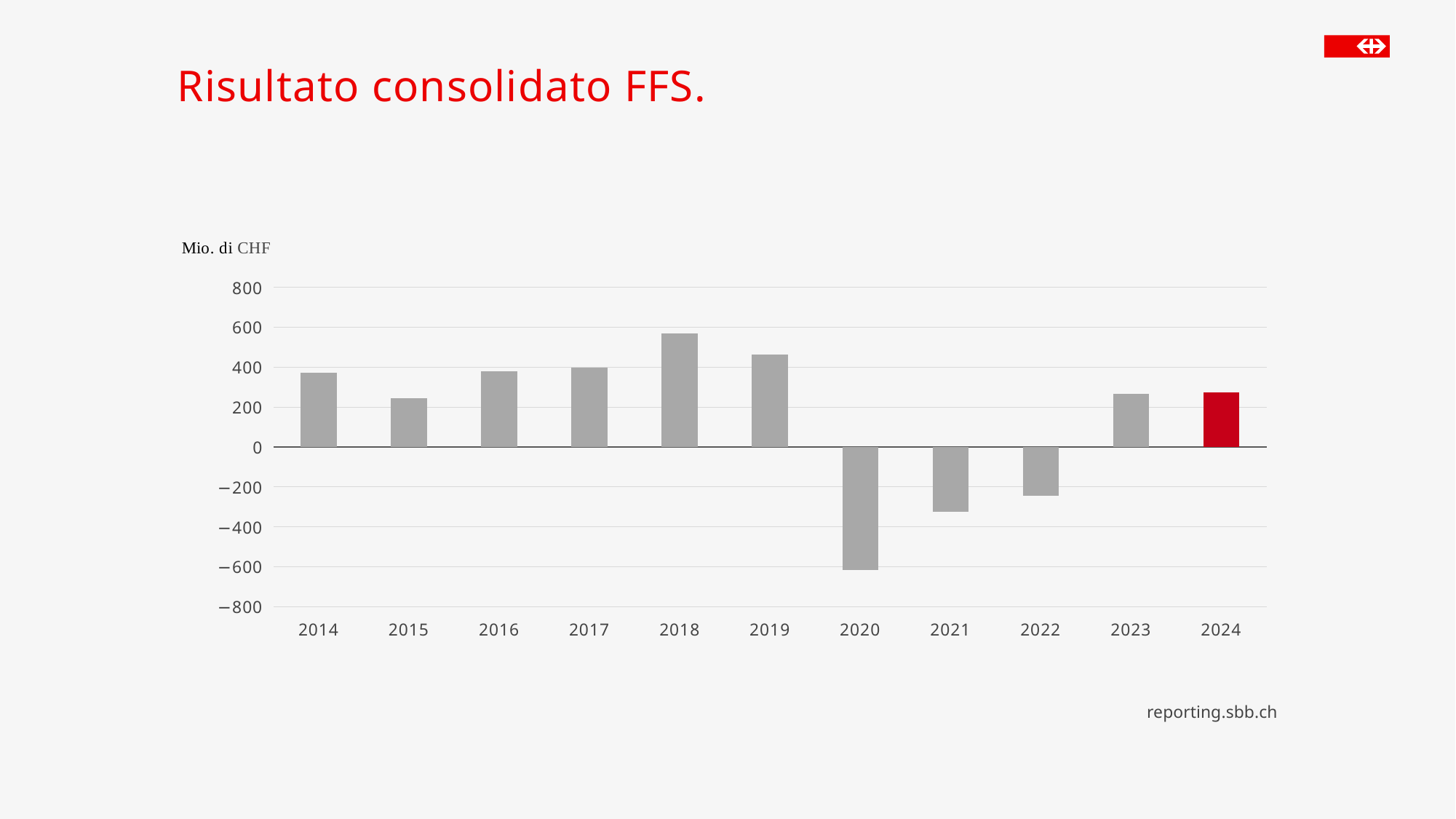
Which year has the larger value, 2021 or 2022? 2022 What kind of chart is shown on the slide? bar chart Which year has the lowest value in the chart? 2020 What unit is shown above the y axis of the chart? Mio. di CHF How many years are shown on the x axis? 11 What is the title of the chart on the slide? Risultato consolidato FFS. Is the value for 2020 greater or less than -400? less Is the value for 2018 greater or less than 400? greater Which year has the larger value, 2018 or 2019? 2018 Which year has the highest value in the chart? 2018 Is the value for 2015 greater or less than 200? greater